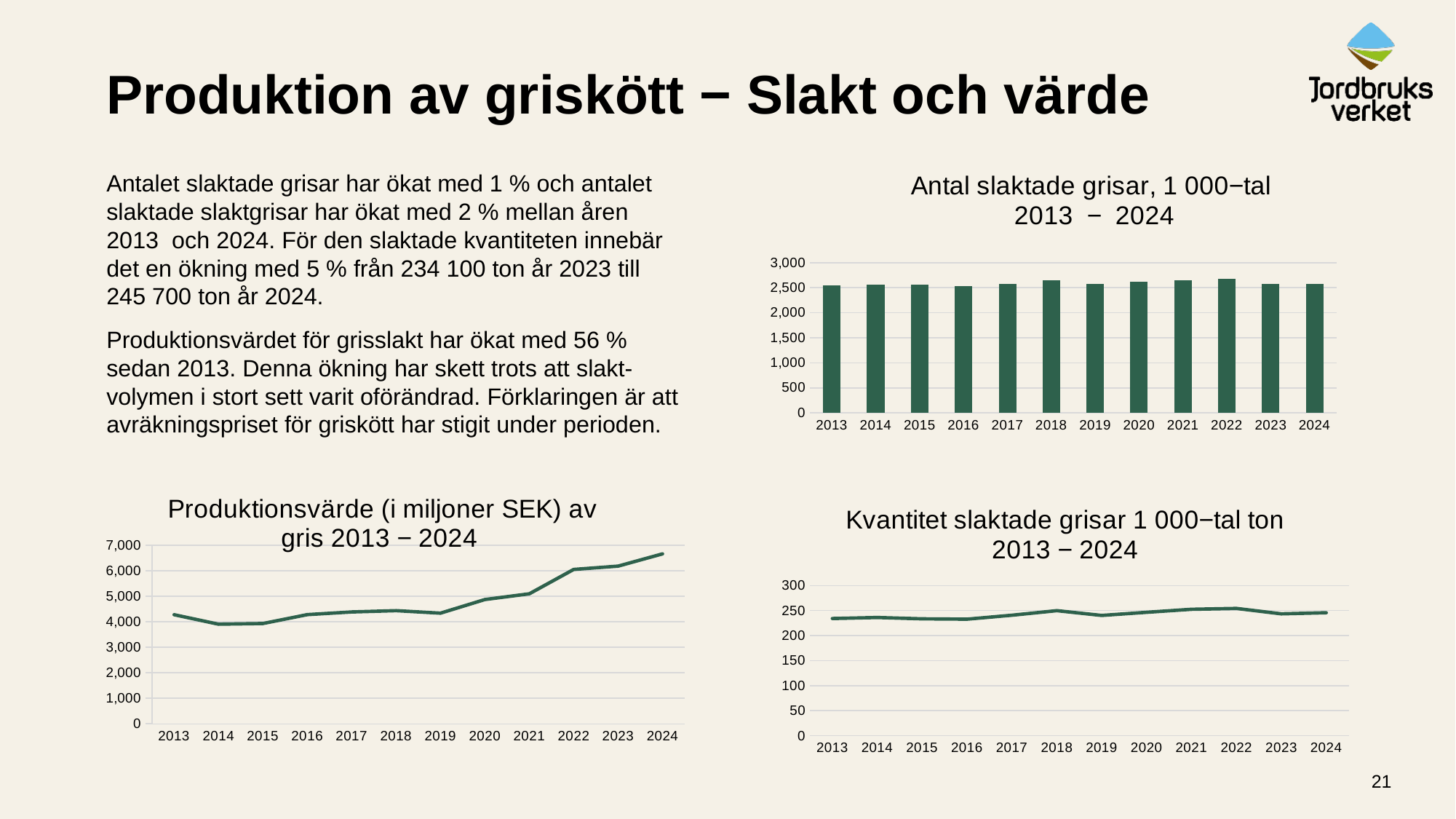
In the 'Kvantitet slaktade grisar 1 000−tal ton' chart, is the value for 2013 greater or less than 250? less In the 'Produktionsvärde (i miljoner SEK) av gris' chart, is the value for 2019 greater or less than 5,000? less What kind of chart is the 'Antal slaktade grisar, 1 000−tal 2013 − 2024' chart? bar chart In the 'Antal slaktade grisar' bar chart, is the value for 2022 greater or less than 3,000? less In the 'Kvantitet slaktade grisar 1 000−tal ton' chart, which is larger, the value for 2013 or the value for 2022? 2022 In the 'Produktionsvärde (i miljoner SEK) av gris' chart, which is larger, the value for 2013 or the value for 2024? 2024 In the 'Produktionsvärde (i miljoner SEK) av gris' chart, which year has the highest value? 2024 What kind of chart is the 'Produktionsvärde (i miljoner SEK) av gris 2013 − 2024' chart? line chart In the 'Produktionsvärde (i miljoner SEK) av gris' chart, do the values generally rise or fall from 2013 to 2024? rise In the 'Antal slaktade grisar' bar chart, how many years are shown on the x axis? 12